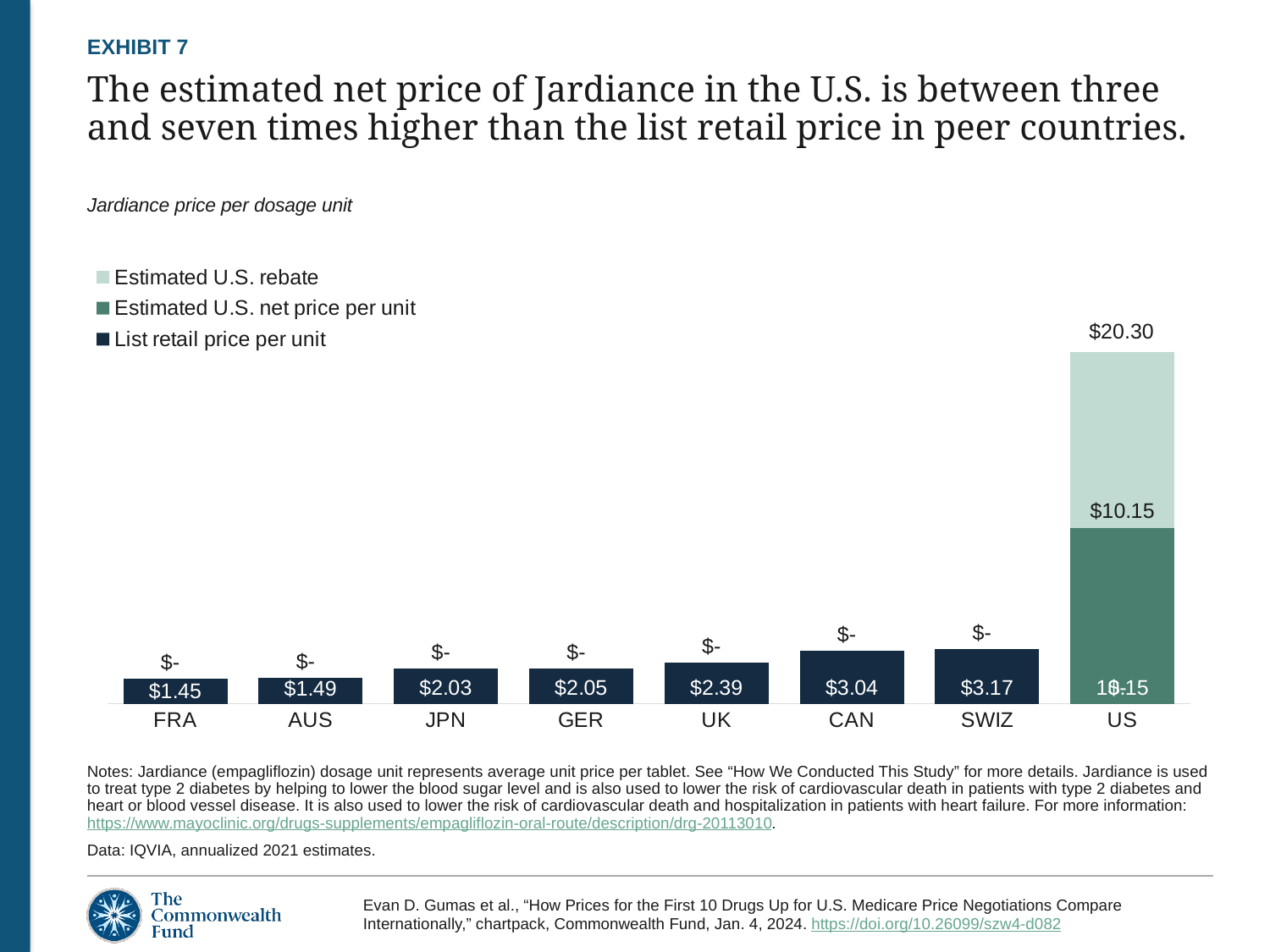
What kind of chart is used to show Jardiance price per dosage unit? Stacked bar chart Which country has the lowest list retail price per unit of Jardiance? FRA What is the list retail price per unit of Jardiance in Switzerland (SWIZ)? $3.17 What is the difference between the list retail price per unit in SWIZ and in FRA? $1.72 How many countries are shown on the x axis of the chart? 8 What is the list retail price per unit of Jardiance in Canada (CAN)? $3.04 What is the difference between the list retail price per unit in CAN and in the UK? $0.65 Among the peer countries (excluding the U.S.), which country has the highest list retail price per unit? SWIZ How many series does the chart legend list? 3 Which has a higher list retail price per unit, JPN or GER? GER What is the list retail price per unit of Jardiance in France (FRA)? $1.45 What is the estimated U.S. net price per unit of Jardiance? $10.15